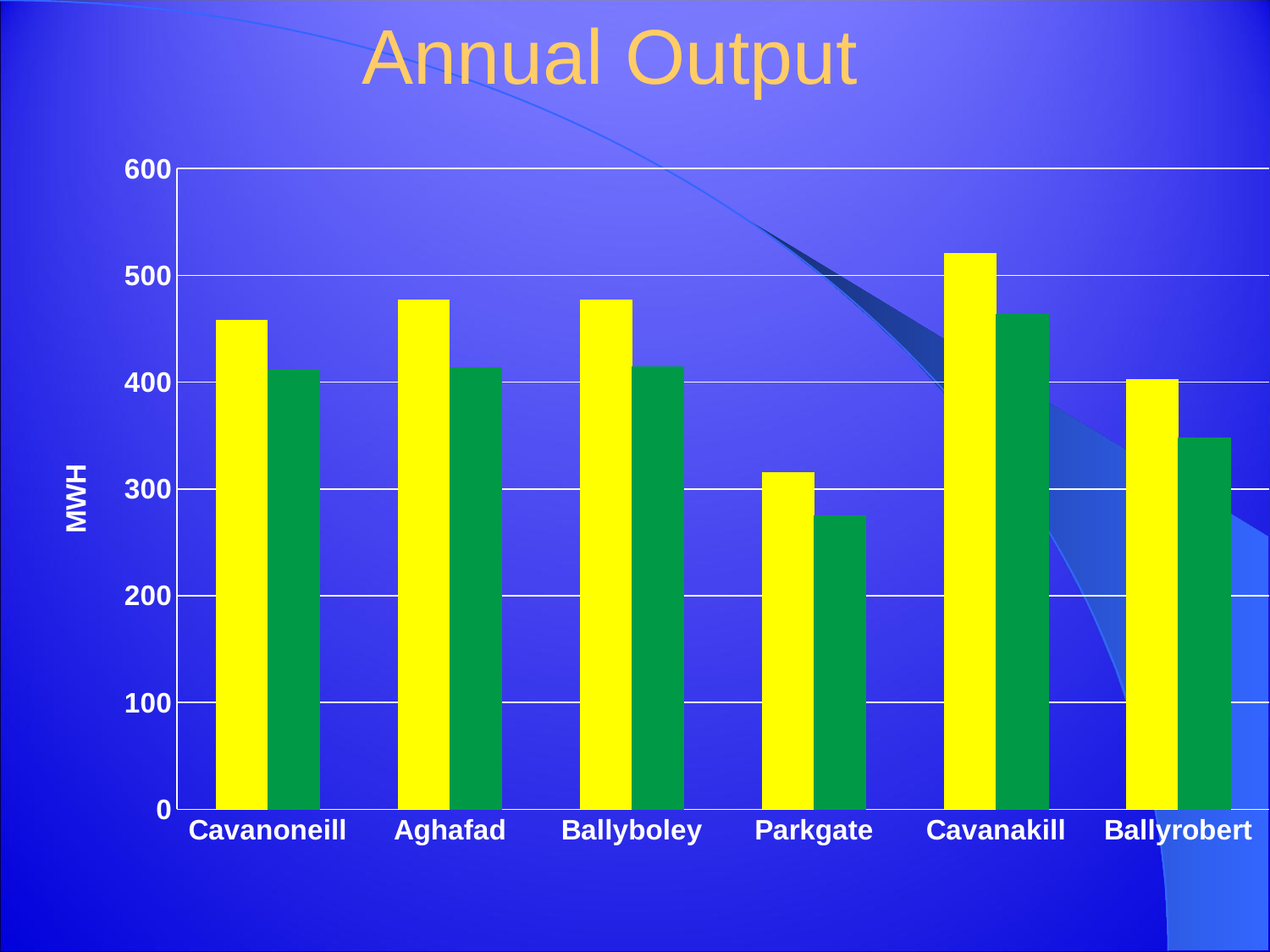
What is the label on the vertical axis? MWH How many categories are shown along the x axis? 6 Which category has the shortest yellow bar? Parkgate Is the green bar for Ballyrobert greater or less than 400? less Which category has the shortest green bar? Parkgate What kind of chart is shown on the slide? bar chart Which is larger, the yellow bar for Cavanakill or the yellow bar for Ballyrobert? Cavanakill Is the green bar for Parkgate greater or less than 300? less What is the title of the chart? Annual Output Which category has the tallest yellow bar? Cavanakill Is the yellow bar for Cavanakill greater or less than 500? greater